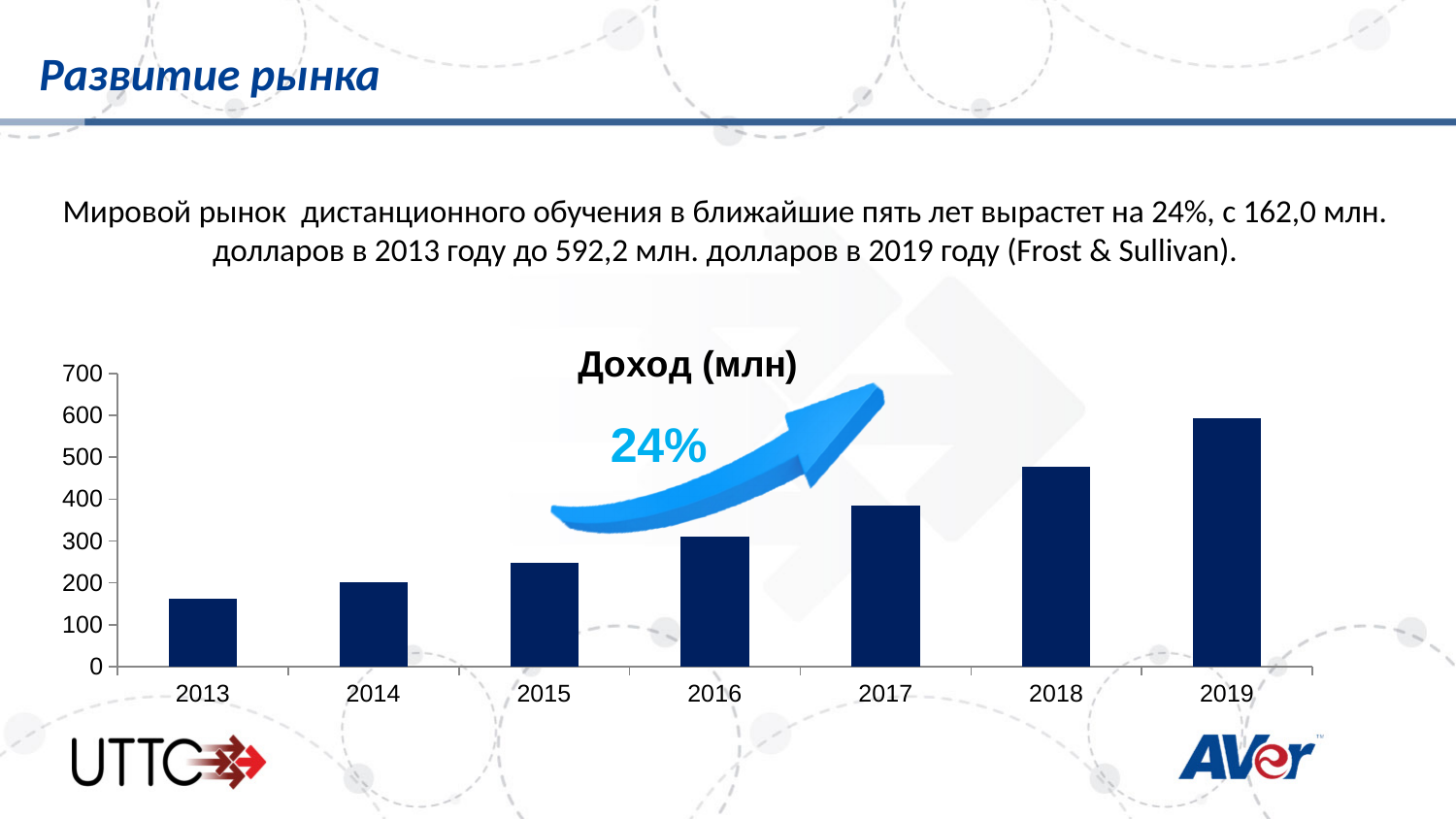
What kind of chart is shown on the slide? bar chart Which is larger, the value for 2017 or the value for 2015? 2017 How many years are shown on the x axis of the chart? 7 What growth percentage is printed next to the arrow on the chart? 24% Is the value for 2013 greater or less than 200? less Do the values rise or fall from 2013 to 2019? rise Is the value for 2015 greater or less than 300? less Which year has the lowest bar in the chart? 2013 Is the value for 2018 greater or less than 500? less What is the title of the chart? Доход (млн) Which year has the highest bar in the chart? 2019